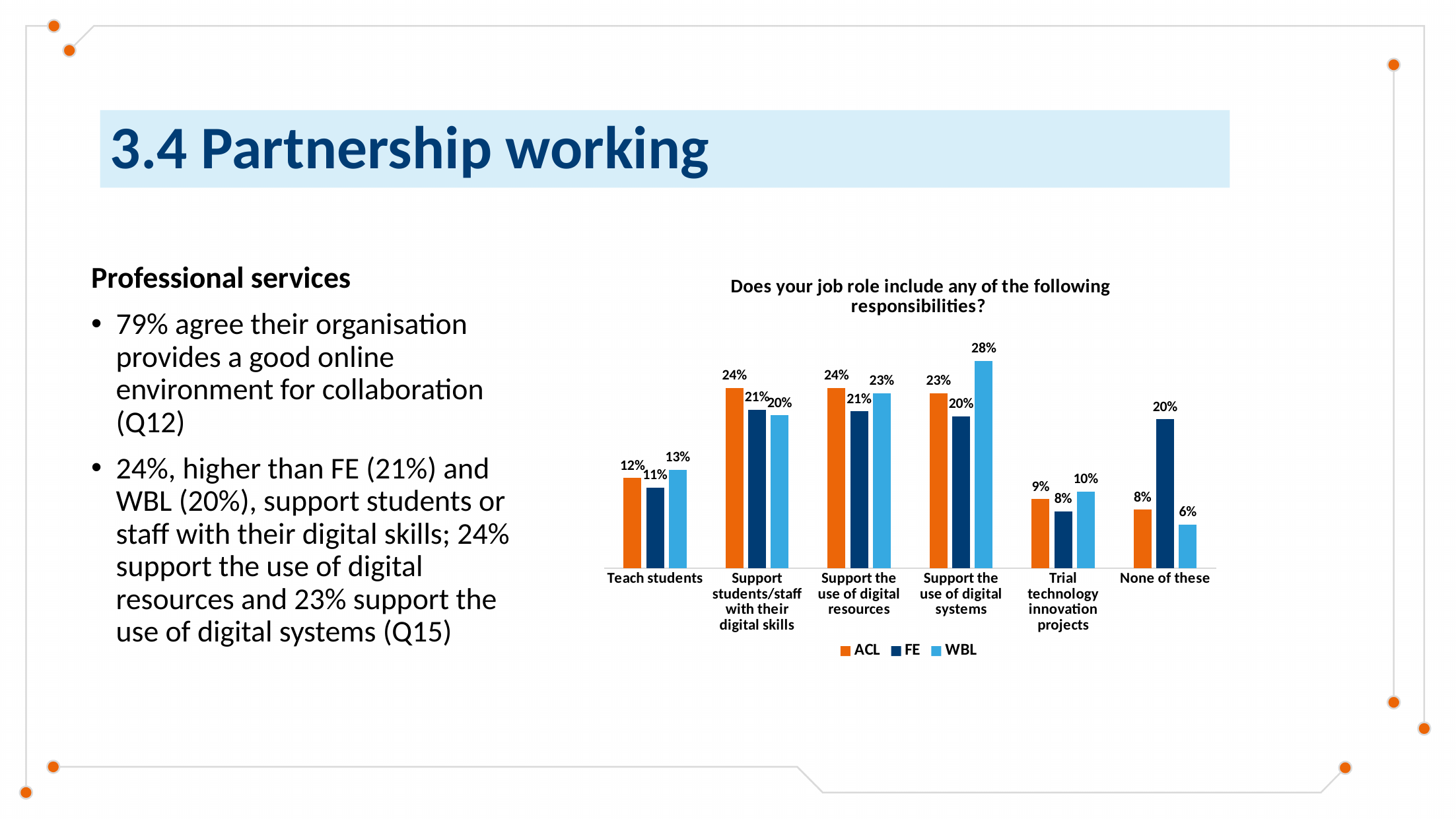
Which category has the highest WBL value? Support the use of digital systems How many categories are shown on the x axis? 6 What kind of chart is shown on the slide? Bar chart What is the WBL value for "Support the use of digital systems"? 28% What is the WBL value for "Trial technology innovation projects"? 10% Which category has the lowest WBL value? None of these What is the difference between the FE and WBL values for "None of these"? 14% What is the title of the chart? Does your job role include any of the following responsibilities? What is the ACL value for "Teach students"? 12% For "Support the use of digital systems", which is larger, the ACL value or the WBL value? WBL What is the FE value for "None of these"? 20% How many series does the legend list? 3